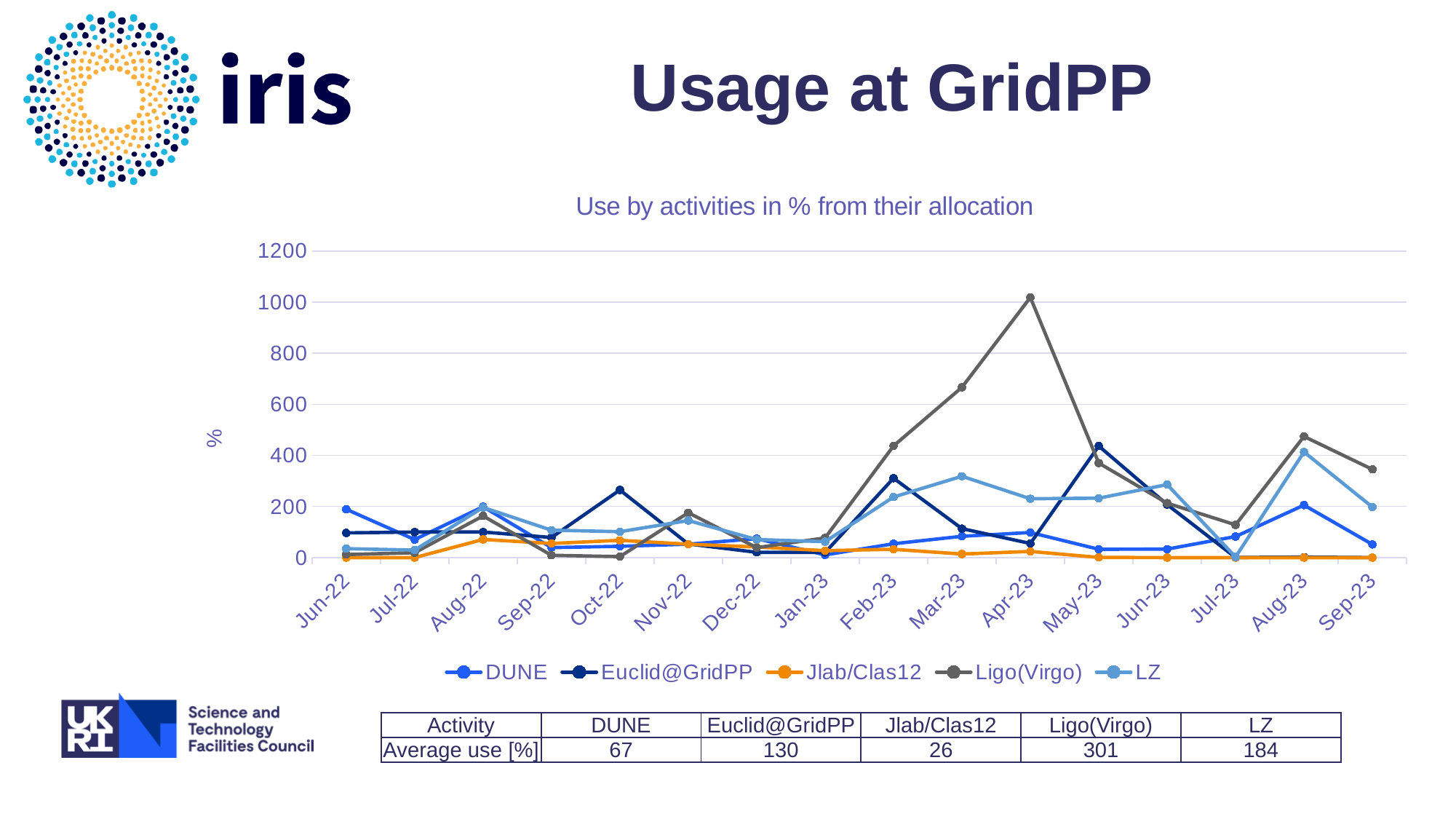
What is the title of the chart? Use by activities in % from their allocation How many months are shown along the x axis? 16 In which month does Ligo(Virgo) reach its peak? Apr-23 Which series reaches the highest value on the chart? Ligo(Virgo) What is the label on the y axis? % How many series does the legend list? 5 Is the value for Euclid@GridPP in Feb-23 greater or less than 200? greater Does the Ligo(Virgo) line rise or fall from Jan-23 to Apr-23? rise Is the value for Jlab/Clas12 in Sep-23 greater or less than 200? less What kind of chart is shown on the slide? line chart Which is larger in Aug-23, the value for LZ or the value for DUNE? LZ